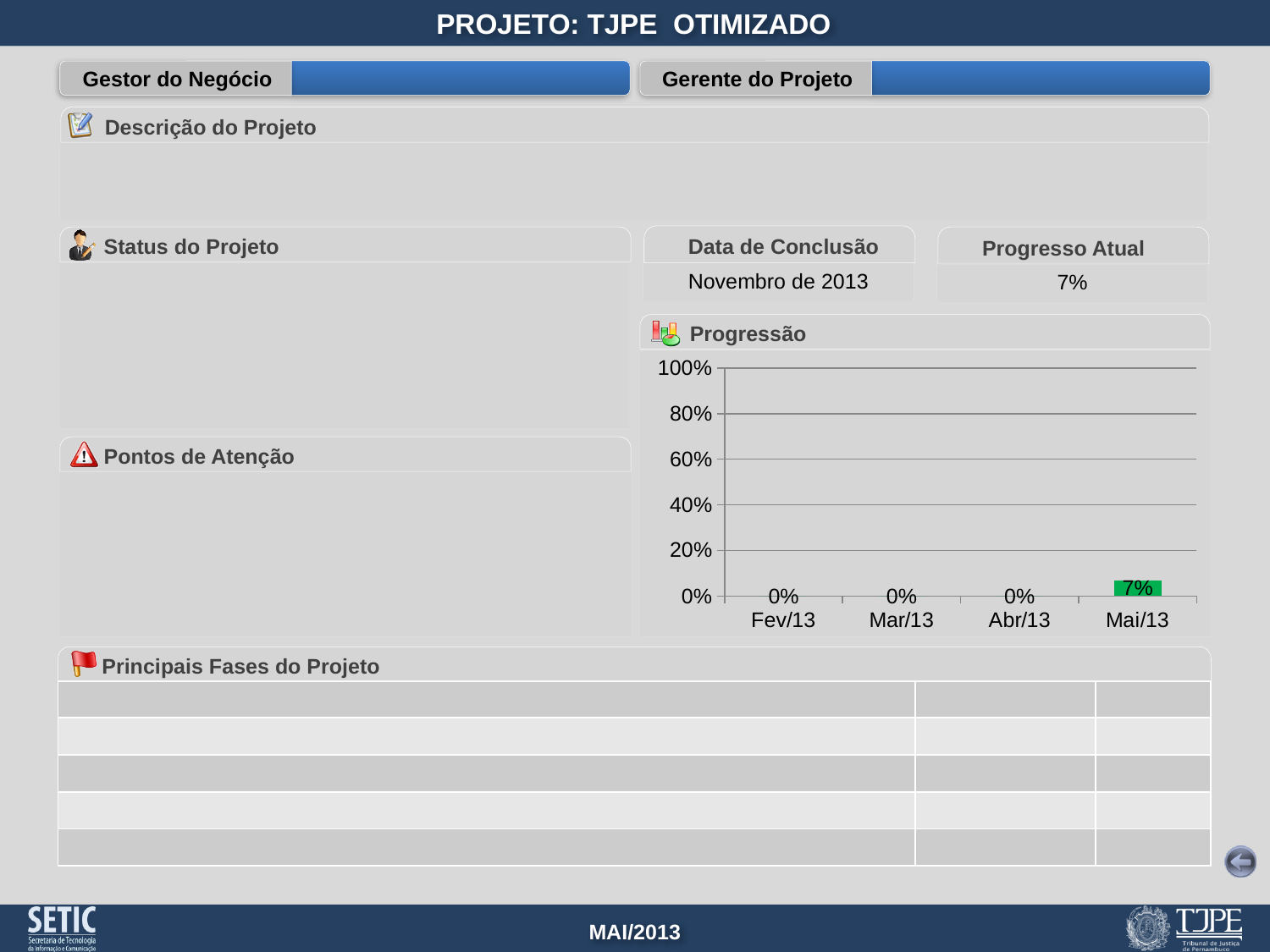
What kind of chart is the Progressão chart? bar chart Which is larger in the Progressão chart, the value for Mar/13 or the value for Mai/13? Mai/13 Is the value for Mai/13 in the Progressão chart greater or less than 20%? less Which month has the highest value in the Progressão chart? Mai/13 Do the values in the Progressão chart rise or fall from Fev/13 to Mai/13? rise What is the highest value shown on the y axis of the Progressão chart? 100% How many months are shown on the x axis of the Progressão chart? 4 What is the value for Fev/13 in the Progressão chart? 0% What is the value for Mai/13 in the Progressão chart? 7% What is the value for Abr/13 in the Progressão chart? 0% What is the difference between the values for Mai/13 and Abr/13 in the Progressão chart? 7% What is the title of the chart on the slide? Progressão